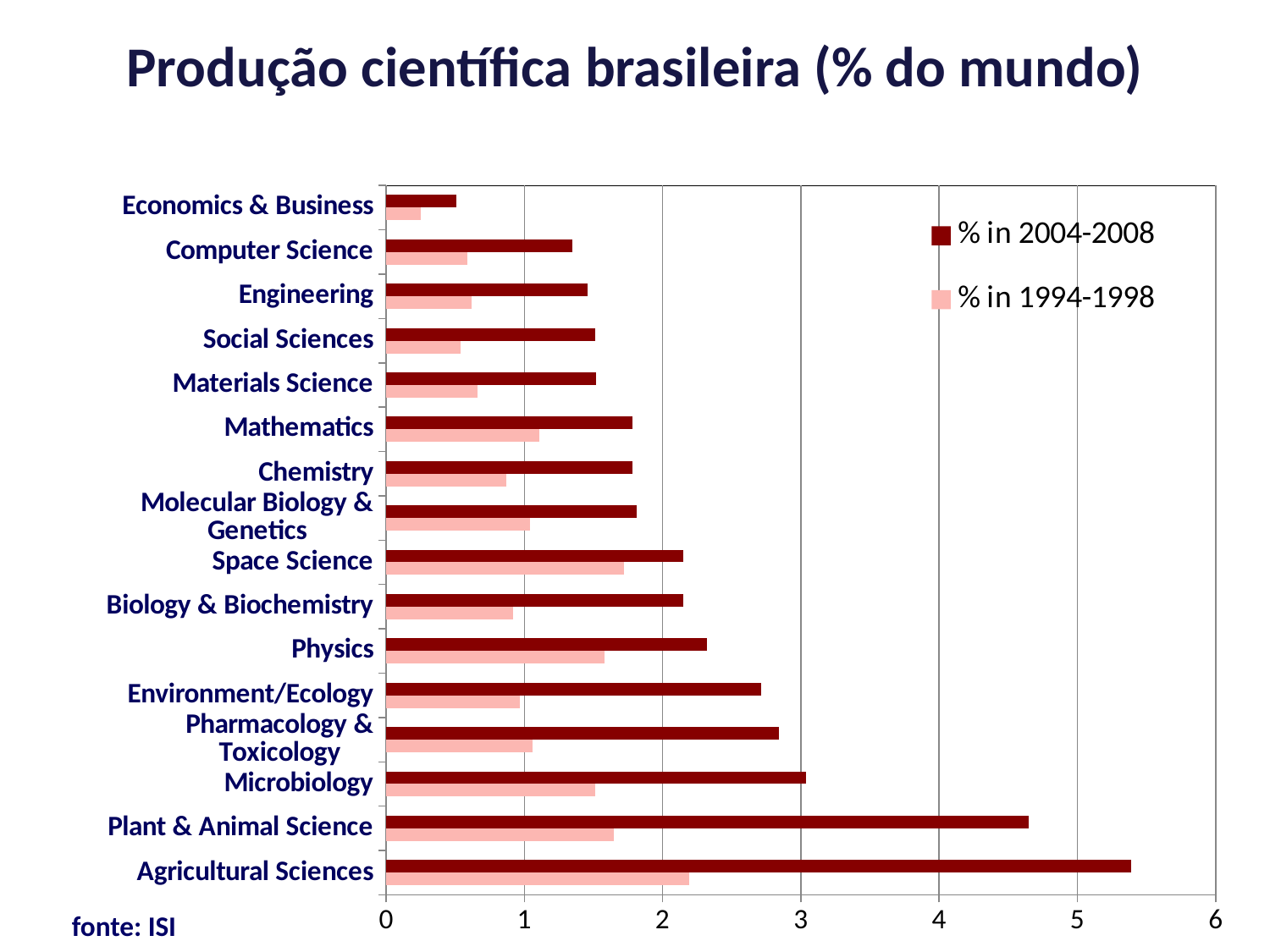
How many series does the legend list? 2 Is the value for Plant & Animal Science in 2004-2008 greater or less than 4? greater Is the value for Agricultural Sciences in 2004-2008 greater or less than 5? greater Is the value for Space Science in 1994-1998 greater or less than 1? greater How many research fields (categories) are shown on the chart? 16 For % in 2004-2008, which is larger: Physics or Mathematics? Physics What kind of chart is shown on the slide? bar chart Which field has the highest value for % in 1994-1998? Agricultural Sciences Which field has the lowest value for % in 2004-2008? Economics & Business What is the title of the chart on the slide? Produção científica brasileira (% do mundo) Which field has the highest value for % in 2004-2008? Agricultural Sciences